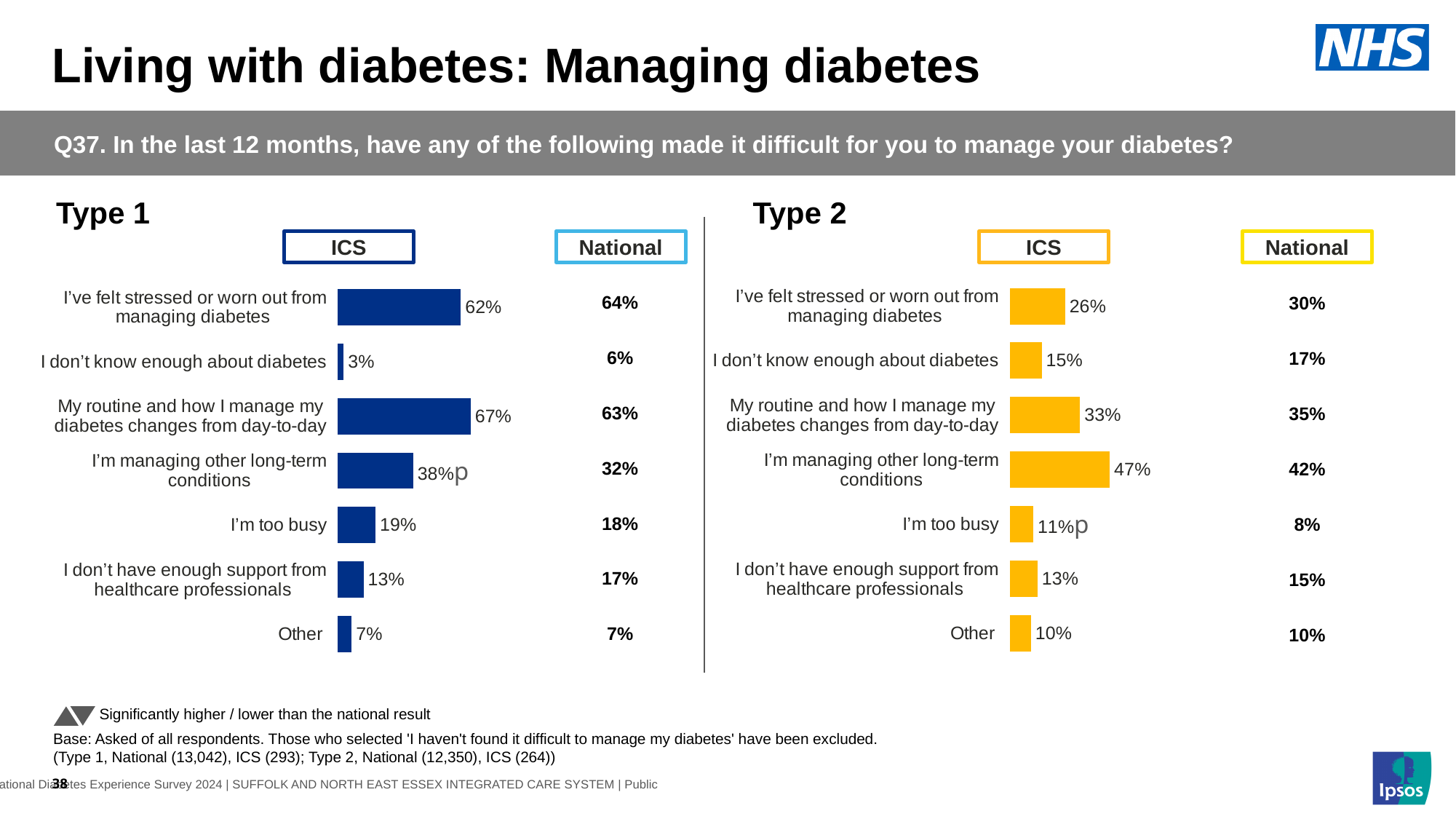
In the Type 2 chart, what is the ICS value for 'I'm managing other long-term conditions'? 47% In the Type 1 chart, what is the difference between the ICS and National values for 'I'm managing other long-term conditions'? 6% In the Type 2 chart, what is the difference between the ICS and National values for 'I'm too busy'? 3% In the Type 2 chart, what is the National value for 'Other'? 10% In the Type 1 chart, which category has the highest ICS value? My routine and how I manage my diabetes changes from day-to-day What kind of chart is used for the ICS values in the Type 1 chart? bar chart In the Type 2 chart, which category has the highest ICS value? I'm managing other long-term conditions In the Type 1 chart, what is the ICS value for 'I've felt stressed or worn out from managing diabetes'? 62% In the Type 1 chart, which category has the lowest ICS value? I don't know enough about diabetes In the Type 2 chart, is the ICS value for 'I don't know enough about diabetes' larger or smaller than the National value? smaller How many categories are shown in the Type 2 chart? 7 In the Type 1 chart, is the ICS value for 'I'm too busy' larger or smaller than the National value? larger